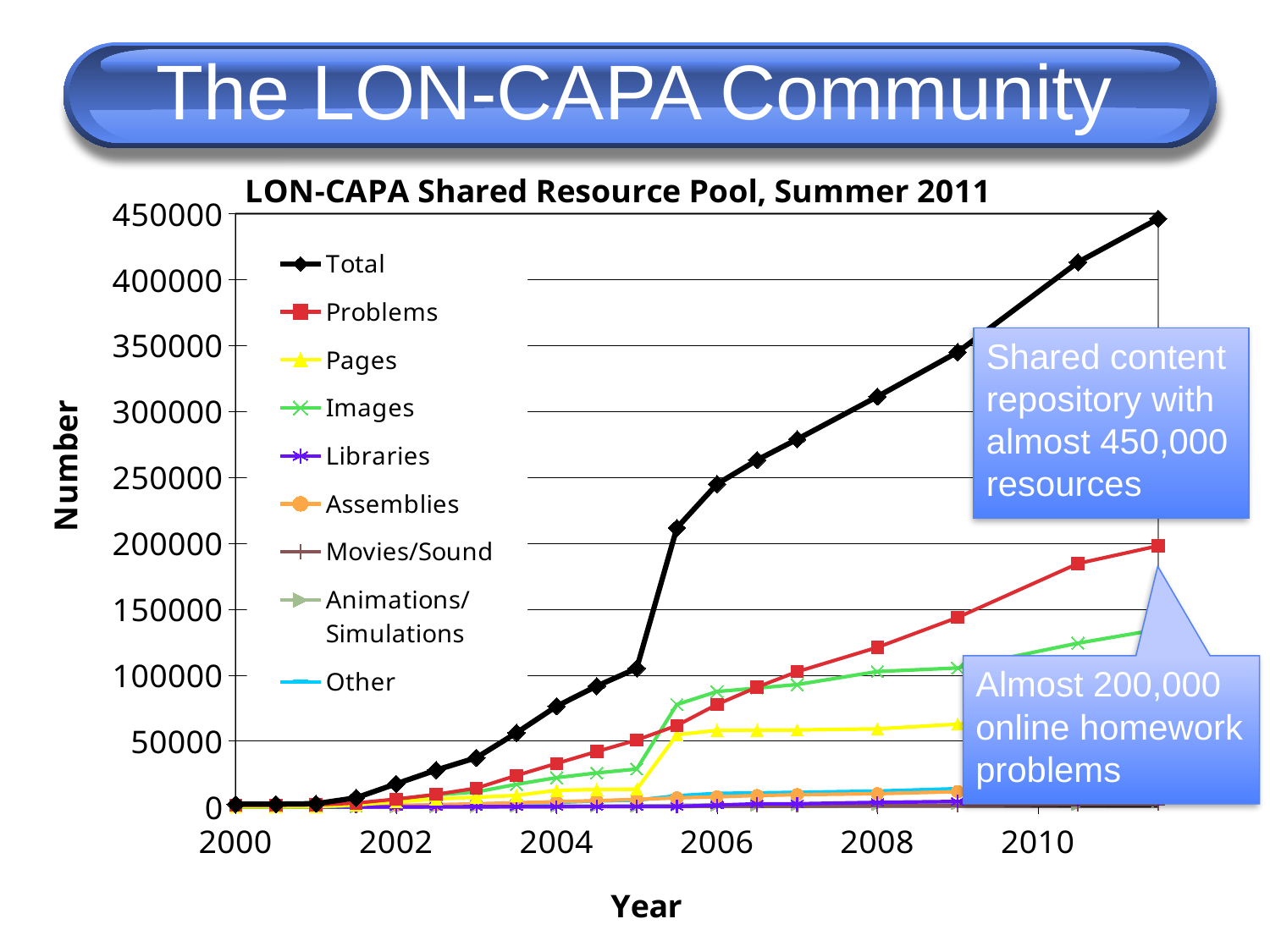
What is the label of the vertical axis? Number Does the Total series rise or fall from 2000 to 2011? rise How many series does the legend list? 9 Is the value for Total in 2008 greater or less than 300000? greater What is the title of the chart? LON-CAPA Shared Resource Pool, Summer 2011 Is the value for Problems in 2008 greater or less than 100000? greater Is the value for Total in 2004 greater or less than 100000? less Which series has the highest value at the right end of the chart? Total What kind of chart is shown on the slide? line chart In 2010, which is larger, the value for Problems or the value for Images? Problems Apart from Total, which series has the highest value at the right end of the chart? Problems